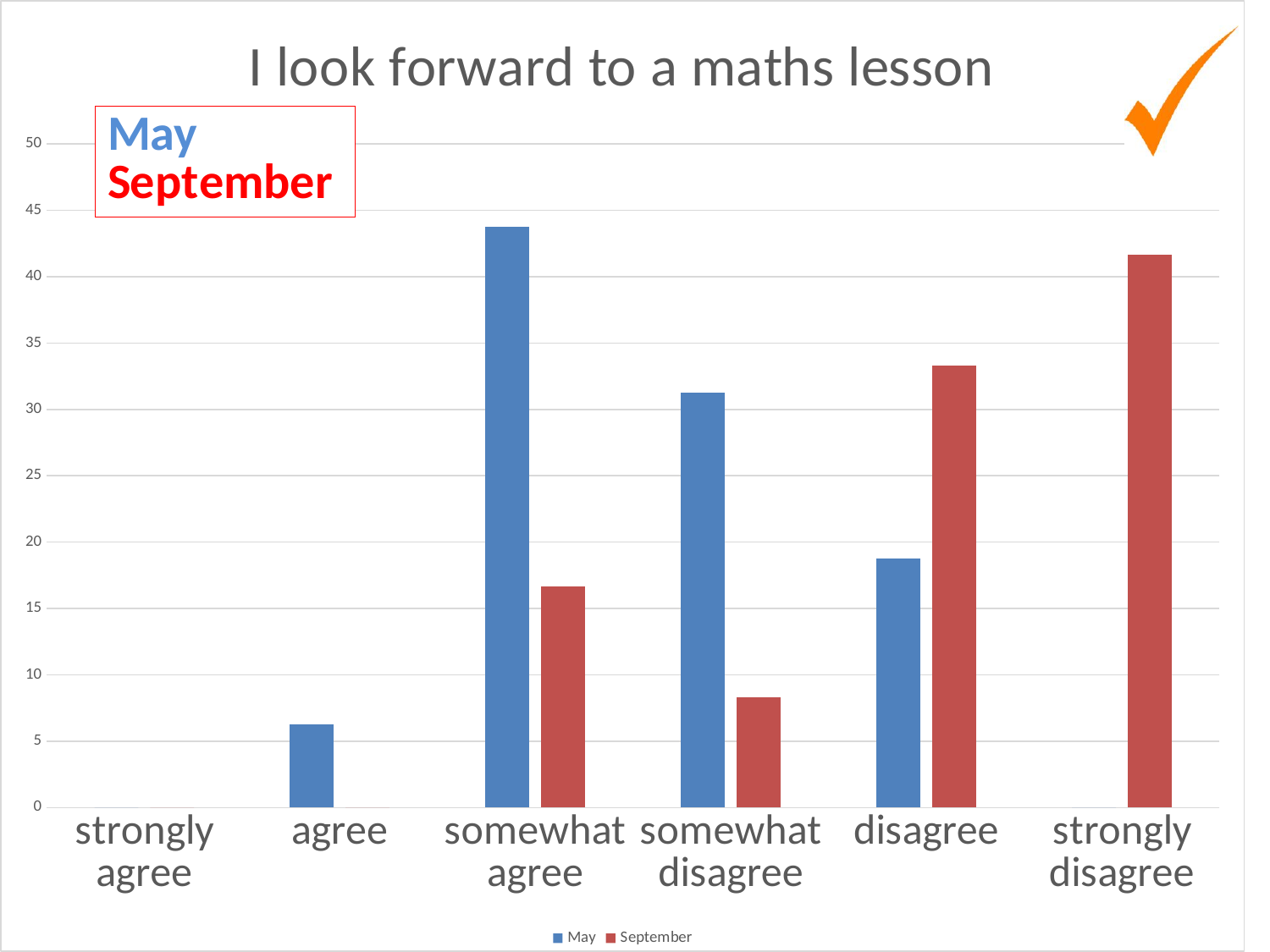
How many categories are shown on the x axis? 6 Is the May value for agree greater or less than 10? less What kind of chart is shown on the slide? bar chart Is the September value for somewhat disagree greater or less than 10? less Which category has the highest value for September? strongly disagree Which category has the highest value for May? somewhat agree Is the May value for somewhat agree greater or less than 40? greater For disagree, which is larger, the May value or the September value? September How many series does the legend list? 2 What is the title of the chart? I look forward to a maths lesson For somewhat agree, which is larger, the May value or the September value? May